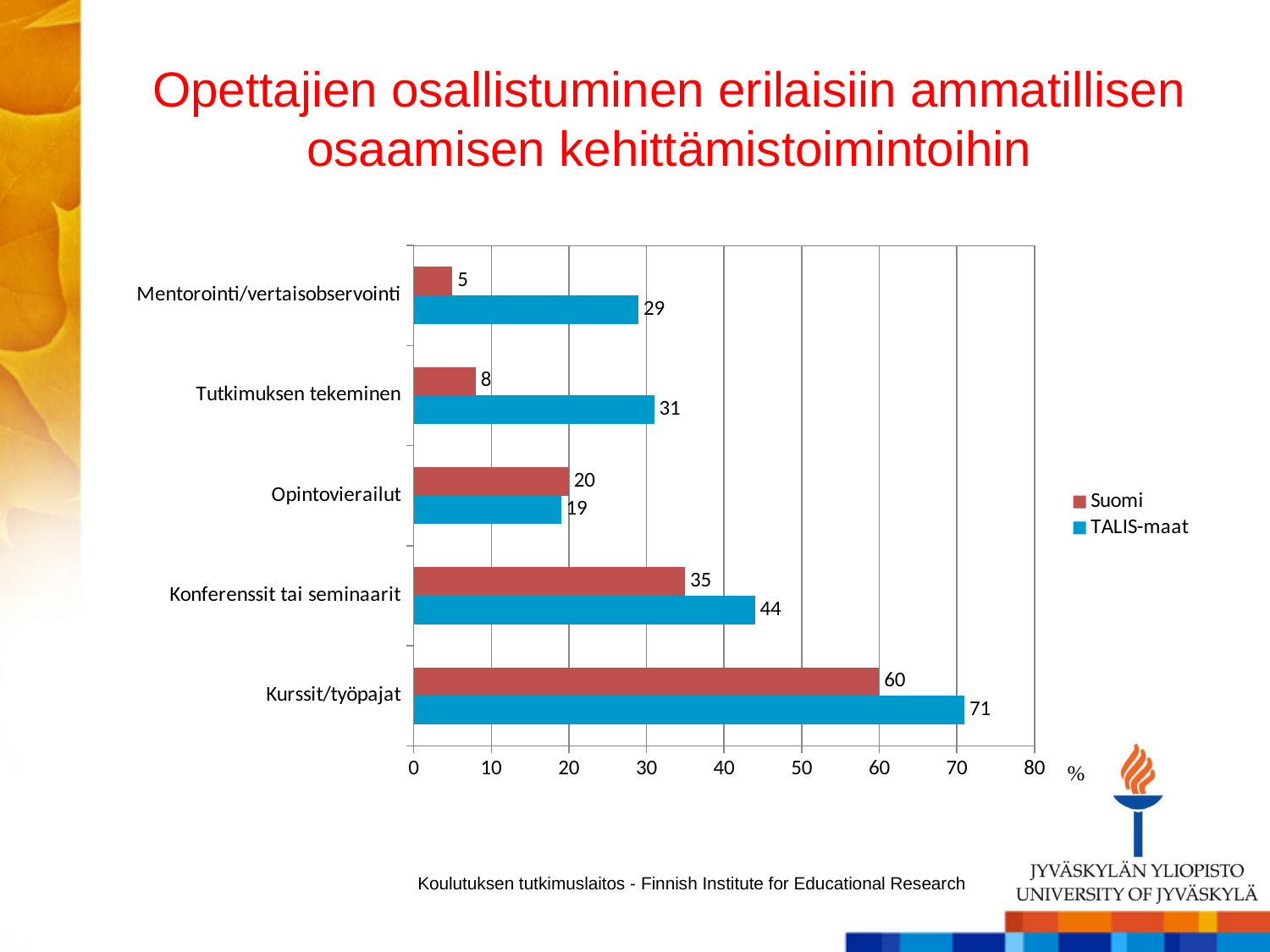
How many series does the legend list? 2 For Opintovierailut, which series has the larger value, Suomi or TALIS-maat? Suomi What kind of chart is shown on the slide? Bar chart What is the Suomi value for Kurssit/työpajat? 60 Which category has the highest TALIS-maat value? Kurssit/työpajat Is the TALIS-maat value for Kurssit/työpajat greater or less than 70? greater Which category has the lowest Suomi value? Mentorointi/vertaisobservointi Which colour represents the Suomi series? Red What is the Suomi value for Tutkimuksen tekeminen? 8 What is the difference between the TALIS-maat and Suomi values for Konferenssit tai seminaarit? 9 What is the TALIS-maat value for Mentorointi/vertaisobservointi? 29 How many categories are shown on the chart? 5